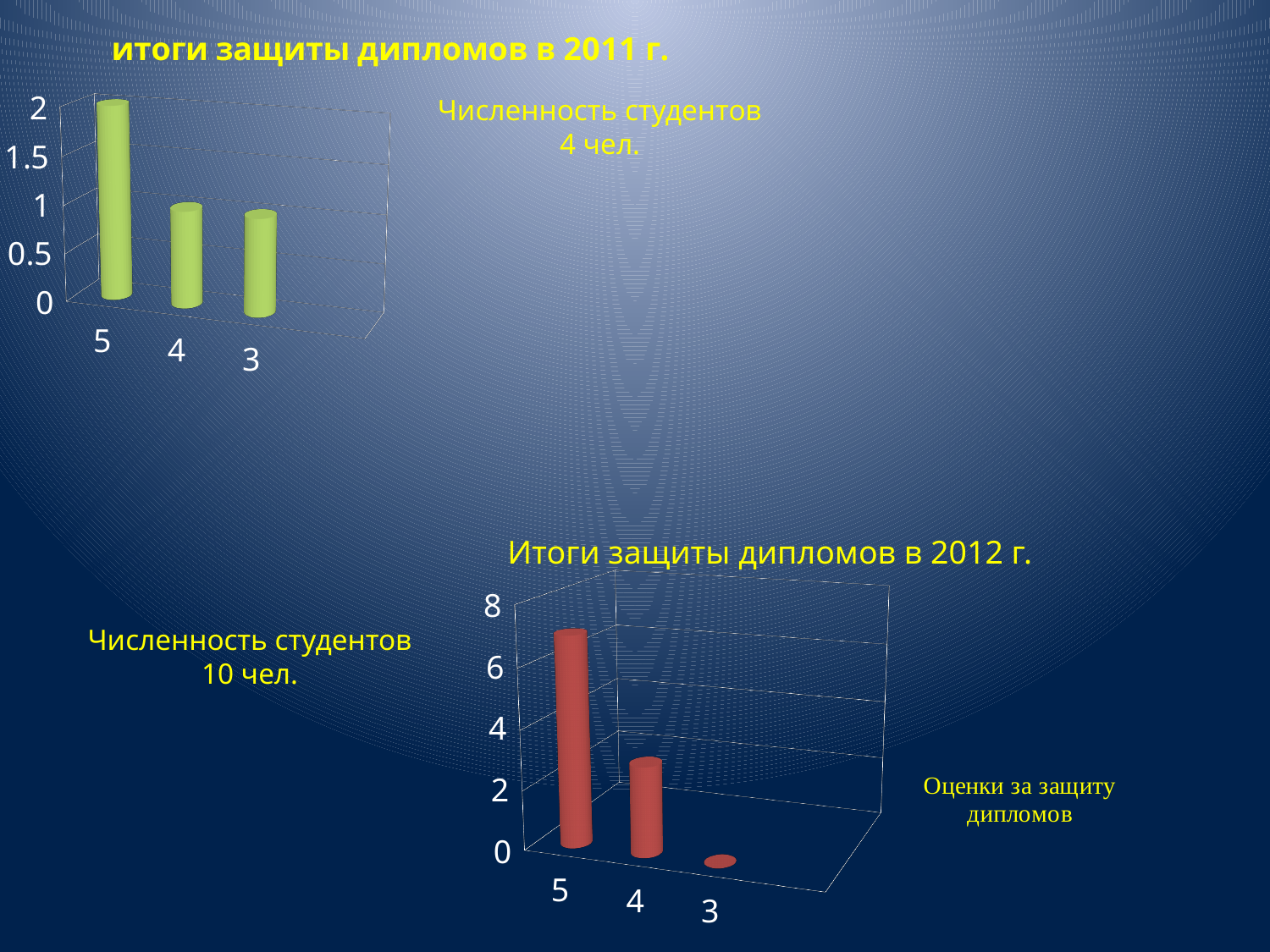
What kind of chart is the bottom chart titled 'Итоги защиты дипломов в 2012 г.'? bar chart In the top-left chart (2011), how many categories are shown on the x axis? 3 In the bottom chart (2012), is the value for category 5 greater or less than 6? greater In the bottom chart (2012), which category has the highest bar? 5 In the top-left chart (2011), which is larger, the value for category 5 or category 4? 5 In the top-left chart (2011), which category has the highest bar? 5 In the bottom chart (2012), is the value for category 4 greater or less than 4? less In the top-left chart (2011), is the value for category 4 greater or less than 1.5? less In the top-left chart (2011), do the bar values rise or fall from left to right along the x axis? fall In the bottom chart (2012), which category has the lowest bar? 3 What kind of chart is the top-left chart titled 'итоги защиты дипломов в 2011 г.'? bar chart